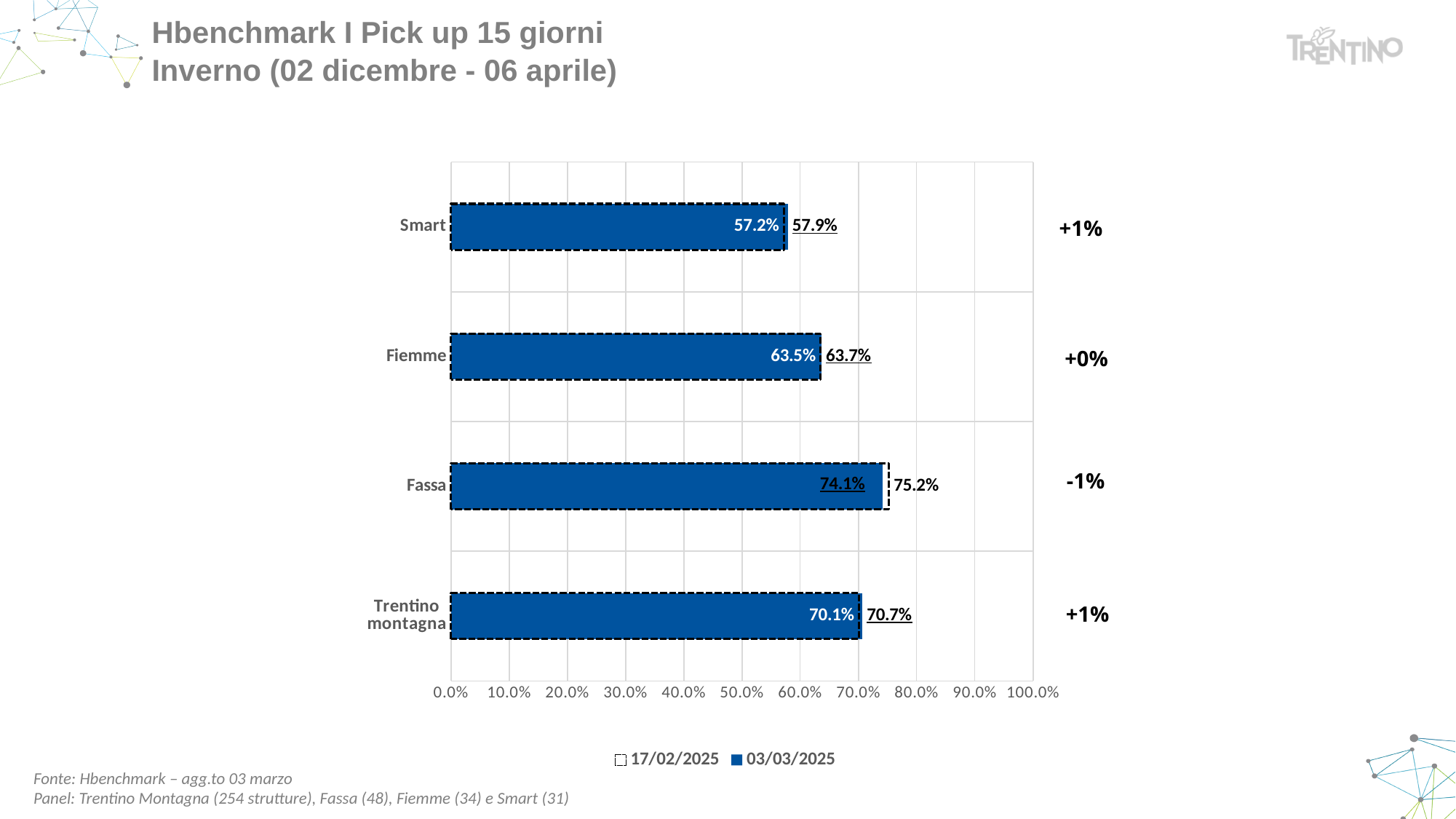
Are the values for Smart greater or less than 60.0%? less How many categories are shown on the chart? 4 What are the two dates listed in the chart legend? 17/02/2025 and 03/03/2025 What two values are printed for Fassa? 74.1% and 75.2% Are the values for Fiemme greater or less than 60.0%? greater Which category has the lowest values on the chart? Smart What percentage change is printed to the right of the Fiemme bars? +0% What kind of chart is shown on the slide? bar chart What percentage change is printed to the right of the Fassa bars? -1% How many series does the legend list? 2 Which category has the highest values on the chart? Fassa What two values are printed for Smart? 57.2% and 57.9%